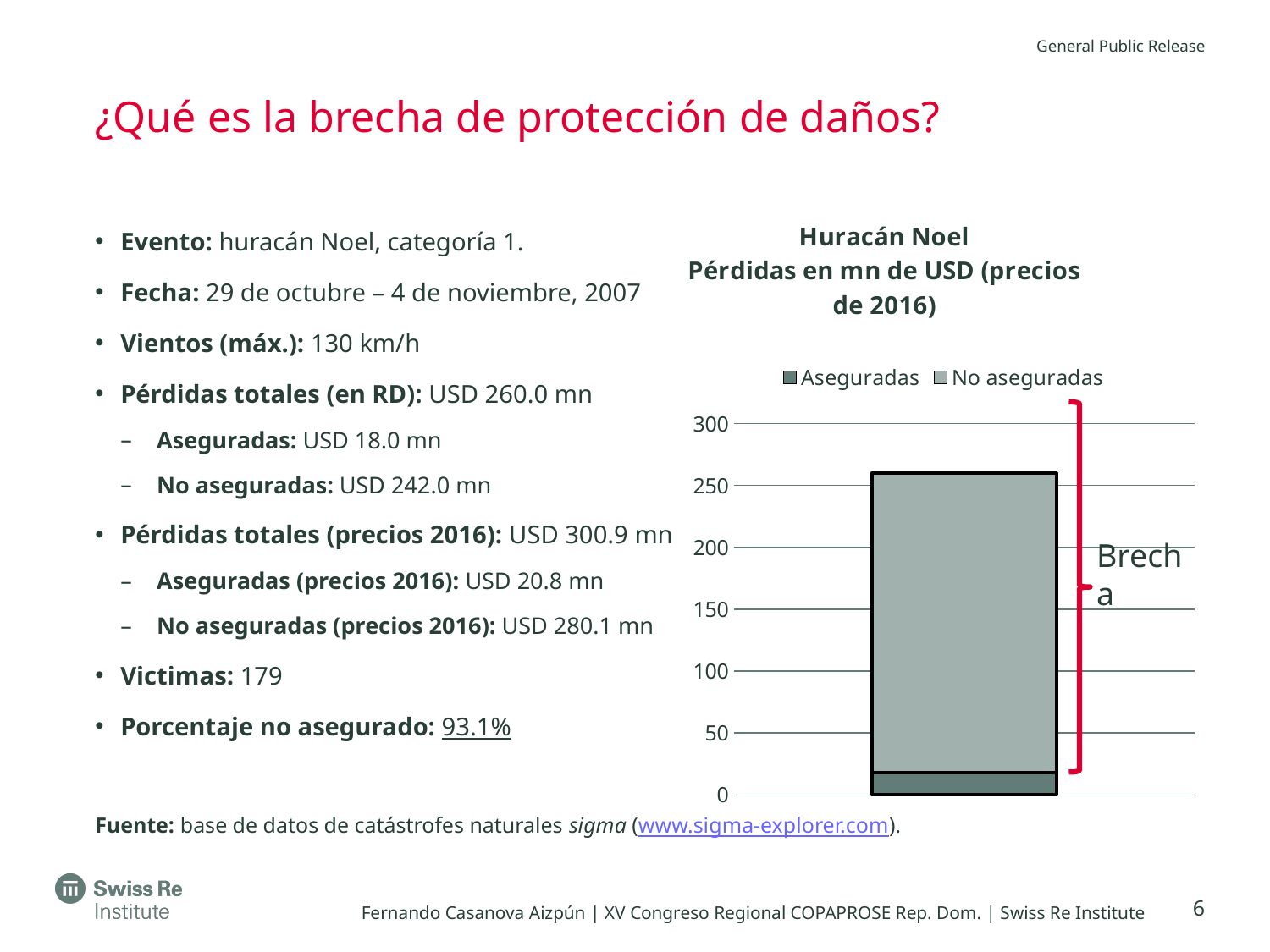
What kind of chart is shown on the slide? Stacked bar chart Which series occupies the larger portion of the bar, Aseguradas or No aseguradas? No aseguradas How many series does the chart legend list? 2 What is the highest value shown on the chart's vertical axis? 300 Is the value of the Aseguradas segment greater or less than 50? less Is the total height of the stacked bar greater or less than 250? greater Which series has the smallest segment in the stacked bar? Aseguradas What is the title of the chart? Huracán Noel Pérdidas en mn de USD (precios de 2016) What are the two series named in the chart legend? Aseguradas and No aseguradas How many bars are plotted in the chart? 1